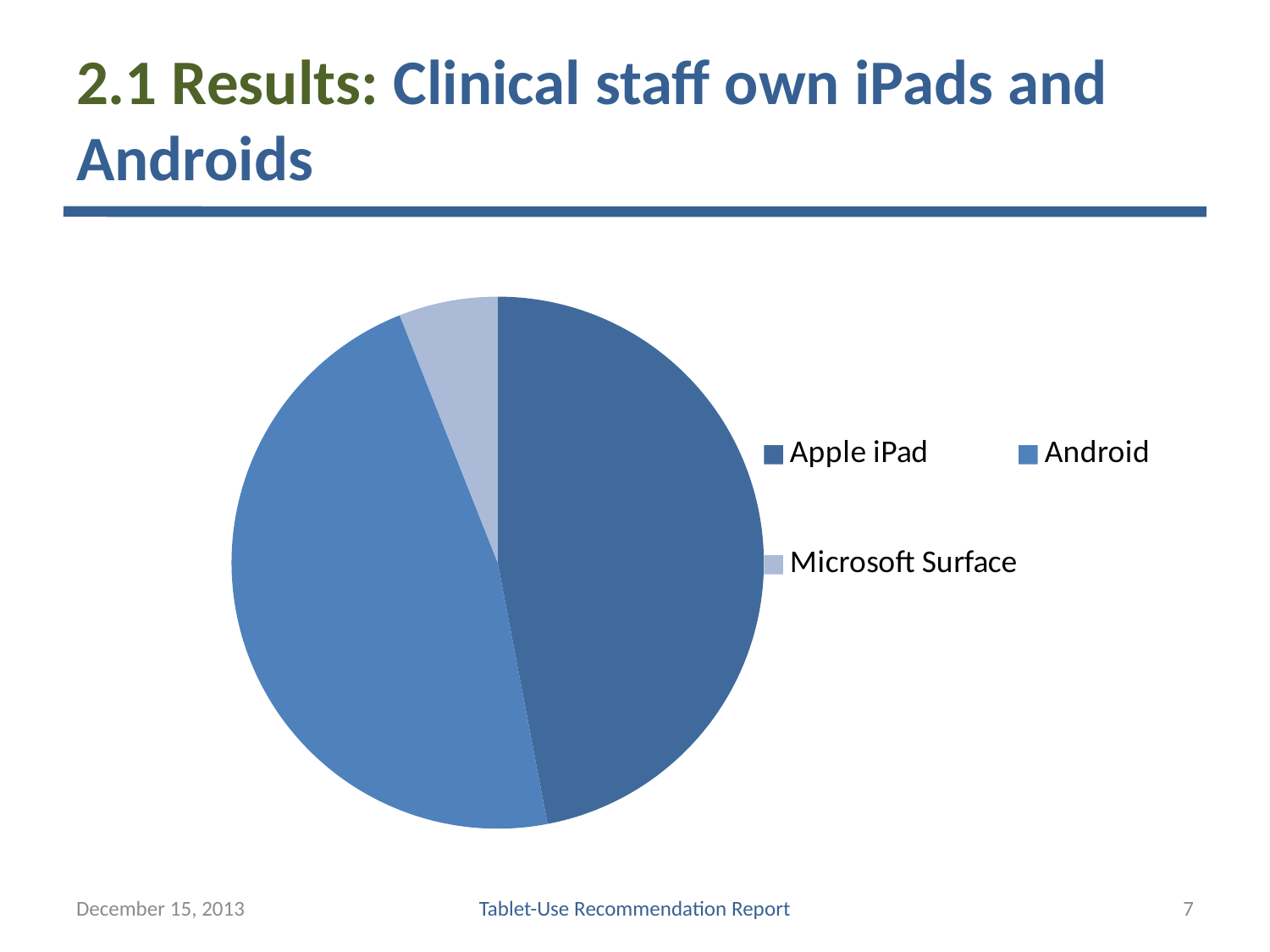
How many slices does the pie chart have? 3 What kind of chart is shown on the slide? pie chart How many entries does the legend of the pie chart list? 3 Which category has the smallest slice of the pie chart? Microsoft Surface Which categories are listed in the legend of the pie chart? Apple iPad, Android, Microsoft Surface Which slice is larger, Android or Microsoft Surface? Android Which slice is larger, Apple iPad or Microsoft Surface? Apple iPad On which side of the pie chart is the legend placed? right